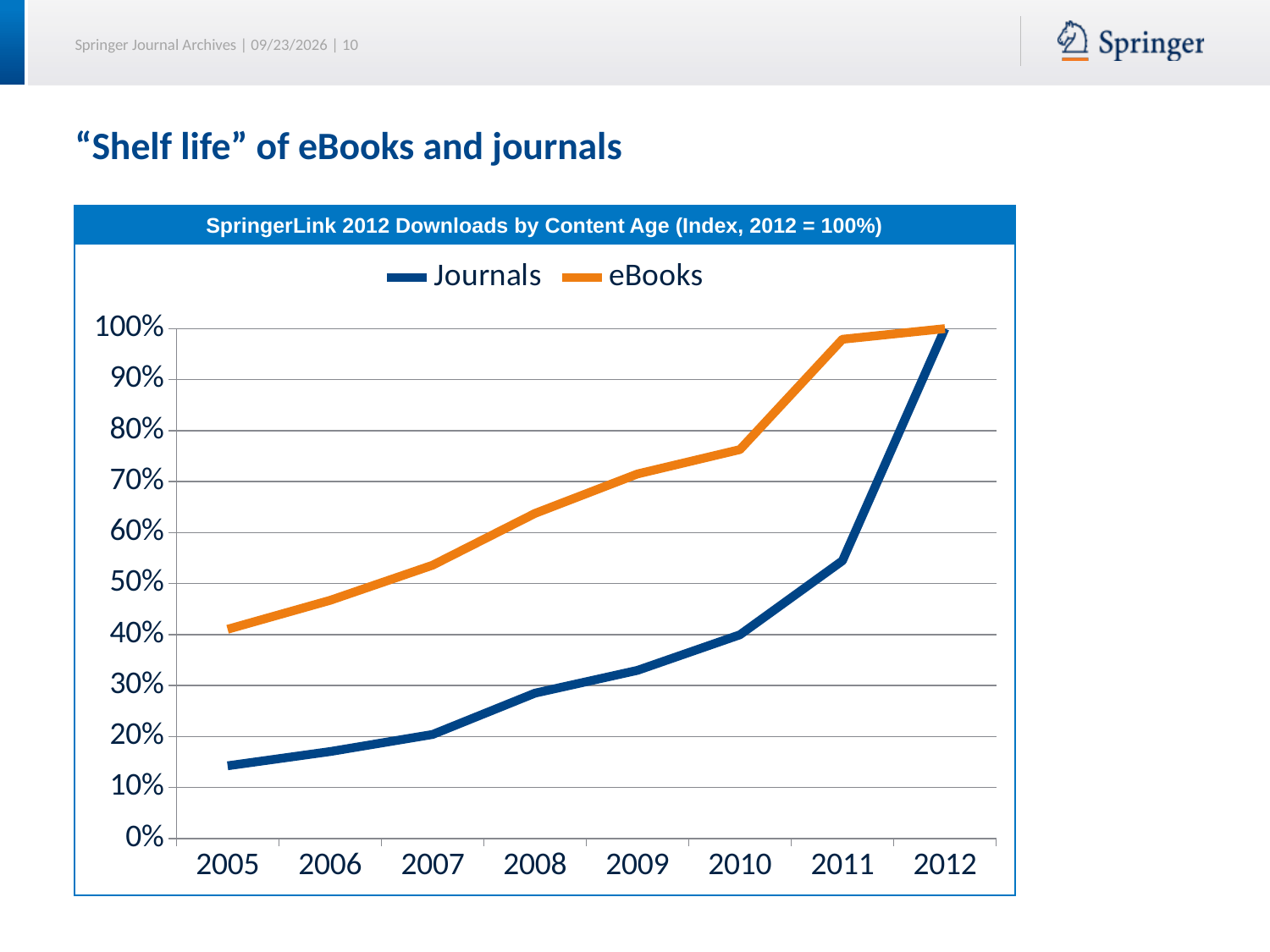
Is the value for eBooks in 2011 greater or less than 90%? greater How many series does the legend list? 2 Is the value for eBooks in 2010 greater or less than 70%? greater Is the value for Journals in 2005 greater or less than 20%? less What is the value for Journals in 2012? 100% What is the title of the chart? SpringerLink 2012 Downloads by Content Age (Index, 2012 = 100%) In 2009, which series has the higher value, Journals or eBooks? eBooks Do the Journals values rise or fall from 2005 to 2012? rise What kind of chart is shown on the slide? line chart How many years are shown on the x axis? 8 What is the value for eBooks in 2012? 100%